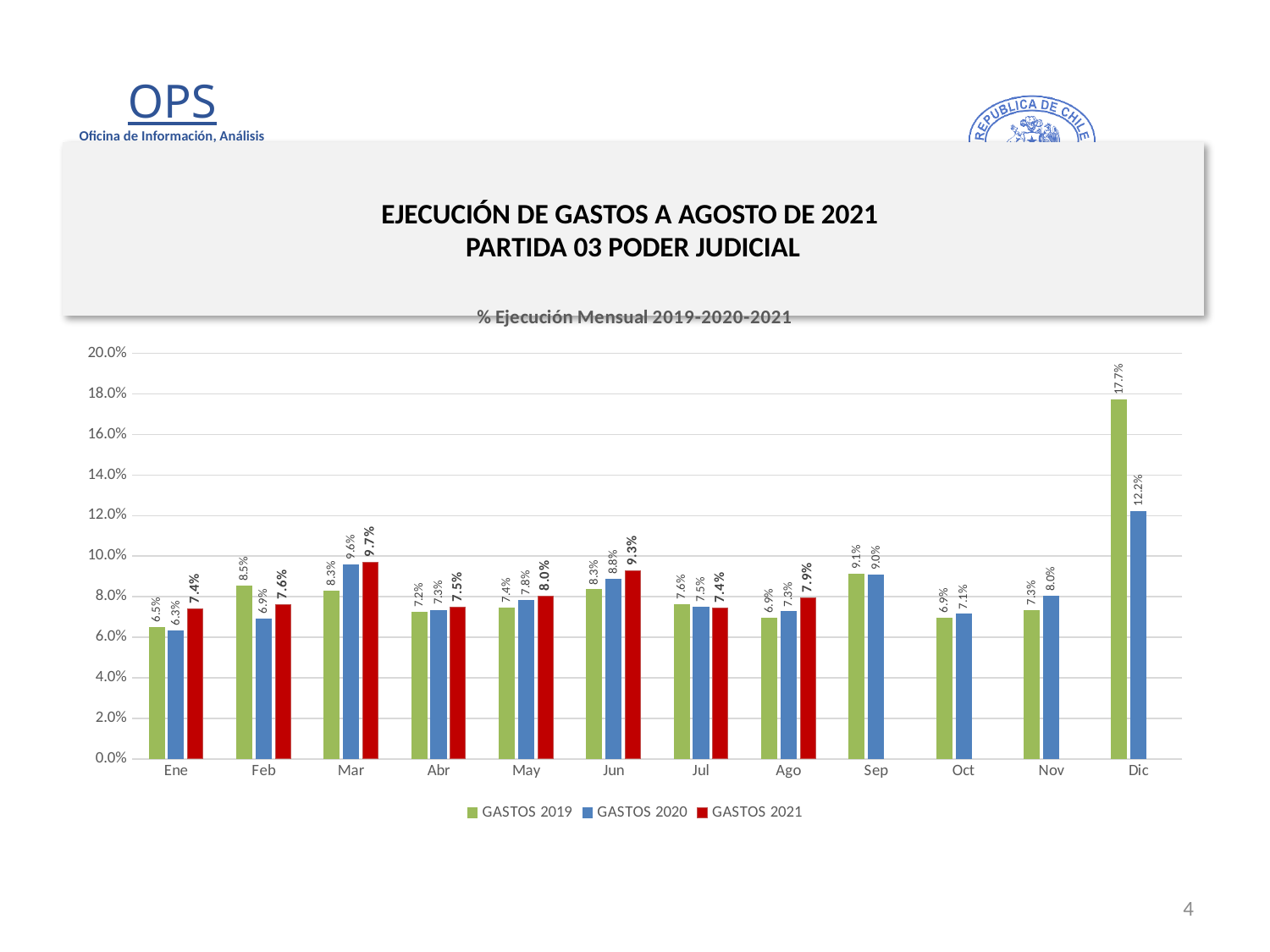
Which is larger in Feb: GASTOS 2019 or GASTOS 2020? GASTOS 2019 What is the value for GASTOS 2019 in Dic? 17.7% Which month has the highest value for GASTOS 2021? Mar What is the value for GASTOS 2021 in Mar? 9.7% Which month has the lowest value for GASTOS 2020? Ene How many series does the legend list? 3 What is the title of the chart? % Ejecución Mensual 2019-2020-2021 What is the difference between GASTOS 2019 and GASTOS 2020 in Dic? 5.5 percentage points What is the value for GASTOS 2020 in Nov? 8.0% What type of chart is shown on the slide? Bar chart How many months are shown on the x axis? 12 Which month has the highest value for GASTOS 2020? Dic